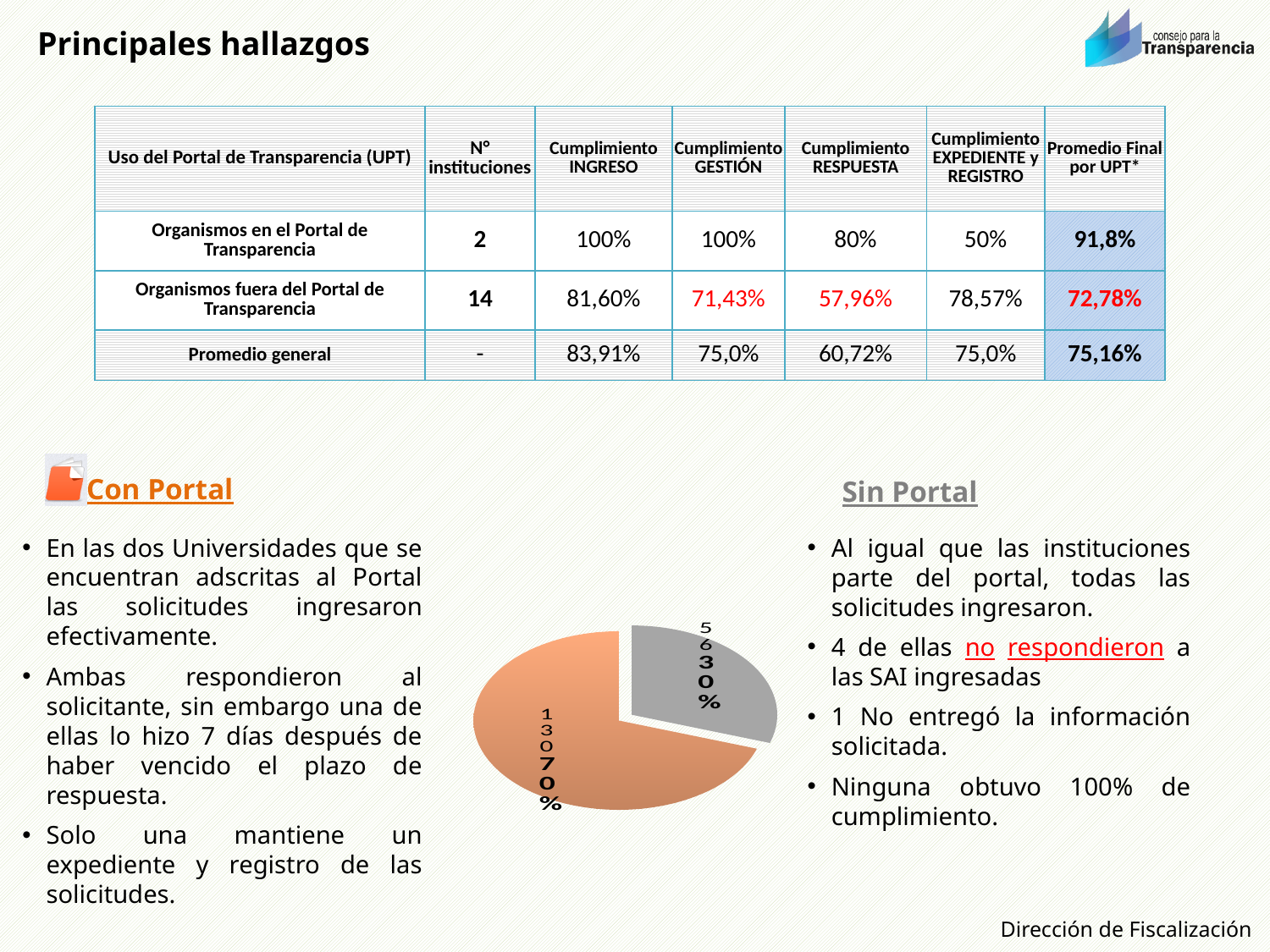
What kind of chart is shown on the slide? pie chart Which slice of the pie chart is larger, the orange one or the gray one? the orange one Does the pie chart have a legend? No Is the gray slice of the pie chart more or less than half of the pie? less Which slice of the pie chart is the largest? the orange slice Is the orange slice of the pie chart more or less than half of the pie? more What two colours are used for the slices of the pie chart? orange and gray How many slices does the pie chart have? 2 Which slice of the pie chart is the smallest? the gray slice